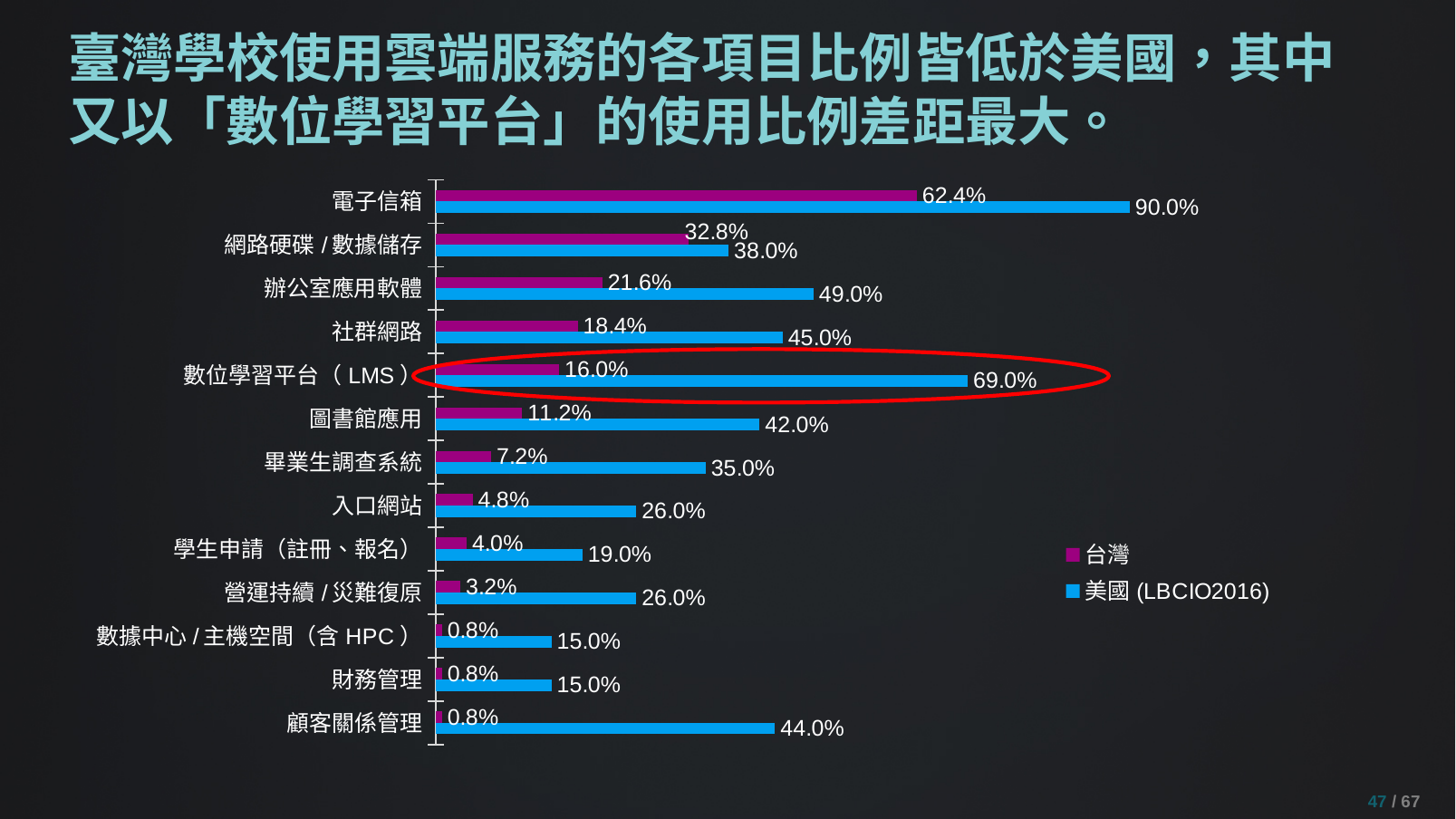
What is the value for 台灣 in the 電子信箱 category? 62.4% How many series does the legend list? 2 What is the value for 台灣 in the 顧客關係管理 category? 0.8% Which is larger: the 台灣 value for 網路硬碟 / 數據儲存 or the 台灣 value for 辦公室應用軟體? 網路硬碟 / 數據儲存 What is the difference between the 美國 (LBCIO2016) and 台灣 values for 電子信箱? 27.6% What is the value for 美國 (LBCIO2016) in the 數位學習平台（LMS） category? 69.0% What is the difference between the 美國 (LBCIO2016) and 台灣 values for 數位學習平台（LMS）? 53.0% How many categories are shown on the chart? 13 Which category has the highest value for 美國 (LBCIO2016)? 電子信箱 Which category has the lowest value for 美國 (LBCIO2016)? 數據中心 / 主機空間（含 HPC）, 財務管理 (both 15.0%) What kind of chart is shown on the slide? Bar chart Which series is shown in blue in the legend? 美國 (LBCIO2016)